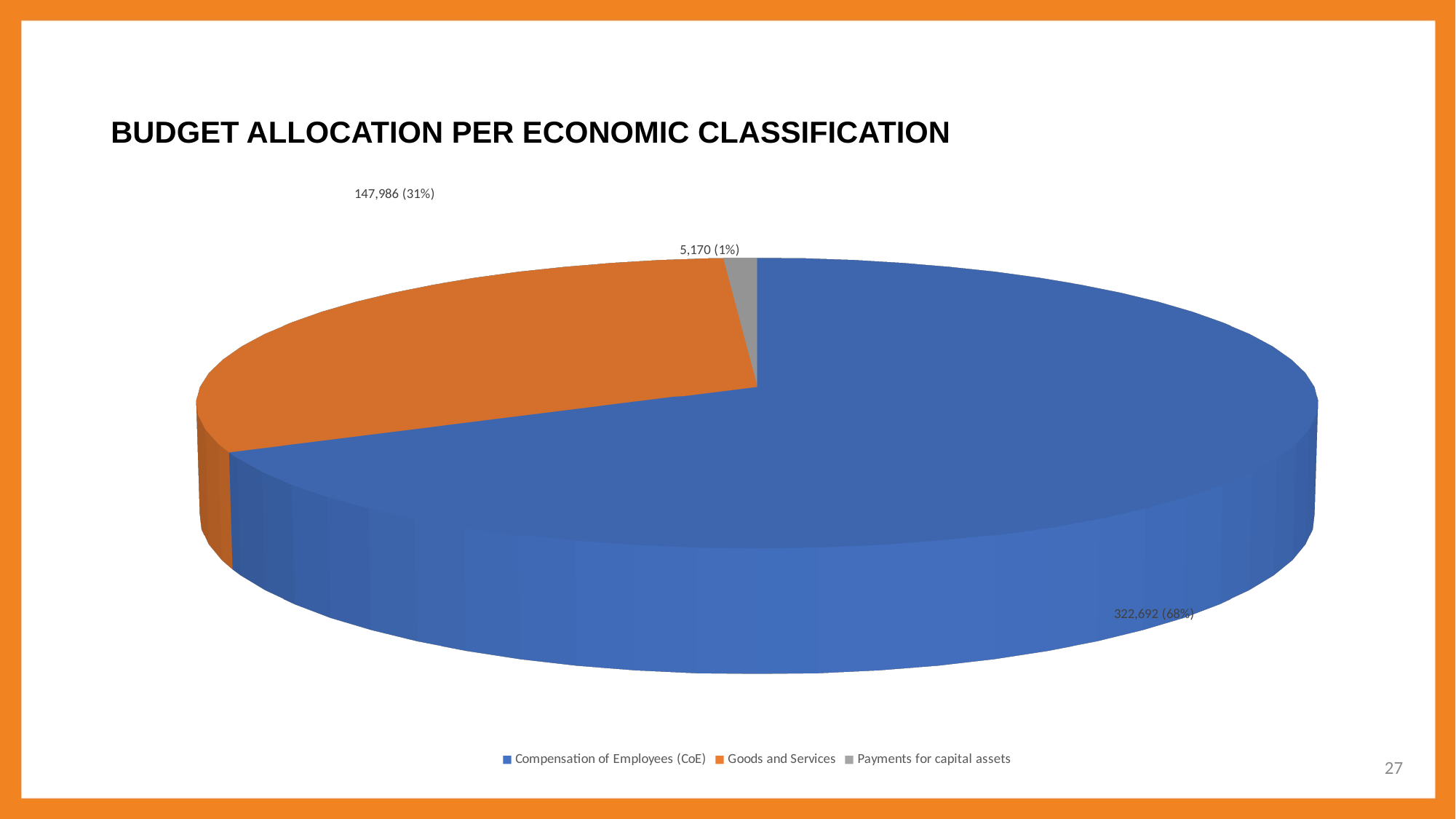
What kind of chart is shown on the slide? Pie chart What share of the pie does Goods and Services represent? 31% What share of the pie does Payments for capital assets represent? 1% What is the value for Payments for capital assets? 5,170 What is the title of the chart? BUDGET ALLOCATION PER ECONOMIC CLASSIFICATION How many categories does the legend list? 3 Which category has the largest slice? Compensation of Employees (CoE) What is the value for Compensation of Employees (CoE)? 322,692 What share of the pie does Compensation of Employees (CoE) represent? 68% What is the difference between the values for Compensation of Employees (CoE) and Goods and Services? 174,706 Which category has the smallest slice? Payments for capital assets What is the value for Goods and Services? 147,986